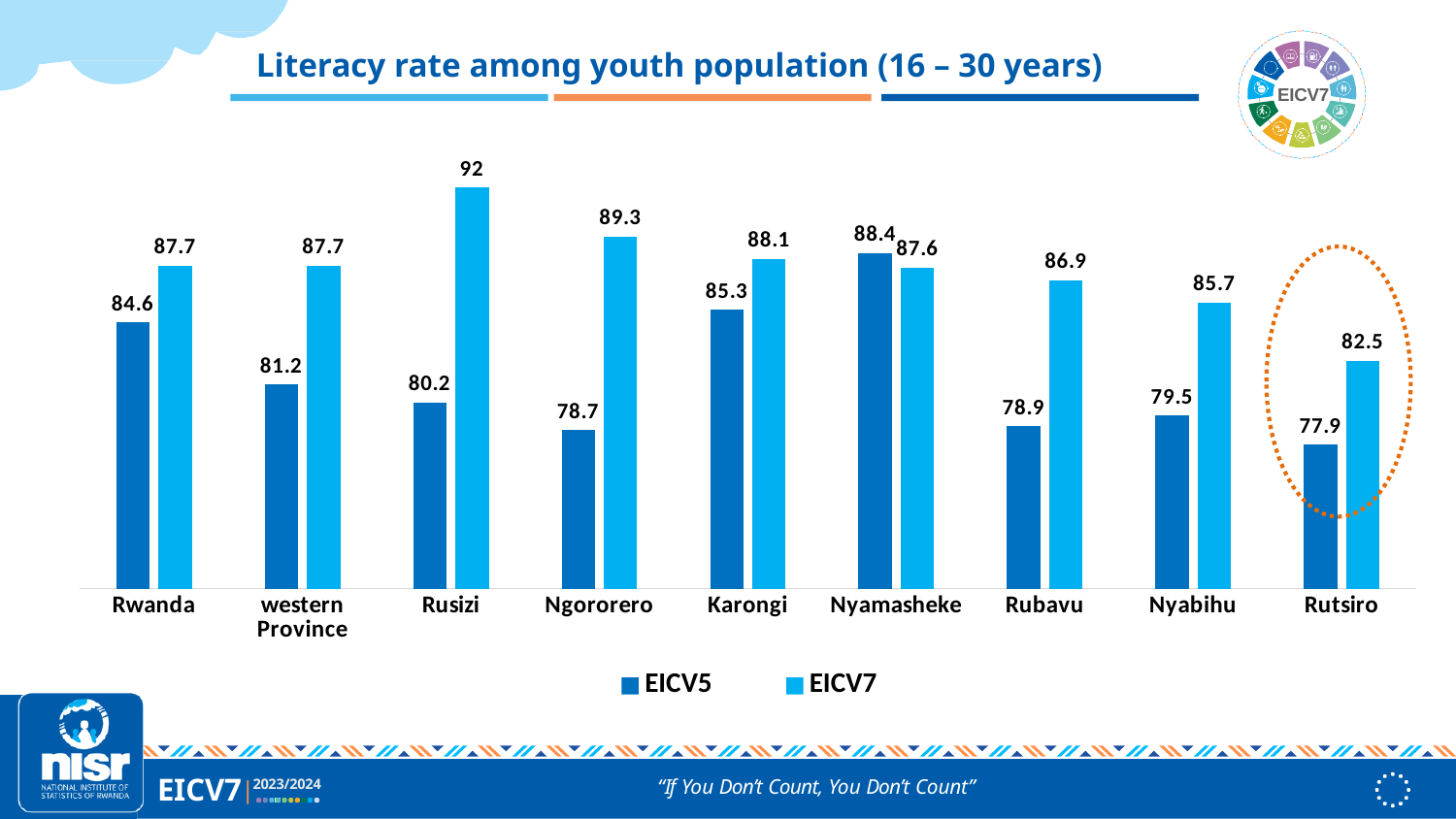
Which category has the lowest EICV5 value? Rutsiro How many series does the legend list? 2 How many categories are shown on the x axis? 9 What is the EICV7 value for Ngororero? 89.3 Which is larger for Nyamasheke, the EICV5 value or the EICV7 value? EICV5 Which category is highlighted with a dotted orange circle? Rutsiro What is the EICV7 literacy rate for Rusizi? 92 What is the difference between the EICV7 and EICV5 values for Rusizi? 11.8 What is the EICV5 literacy rate for Rutsiro? 77.9 Which category has the highest EICV7 value? Rusizi What kind of chart is shown on the slide? Bar chart What is the title of the chart? Literacy rate among youth population (16 – 30 years)